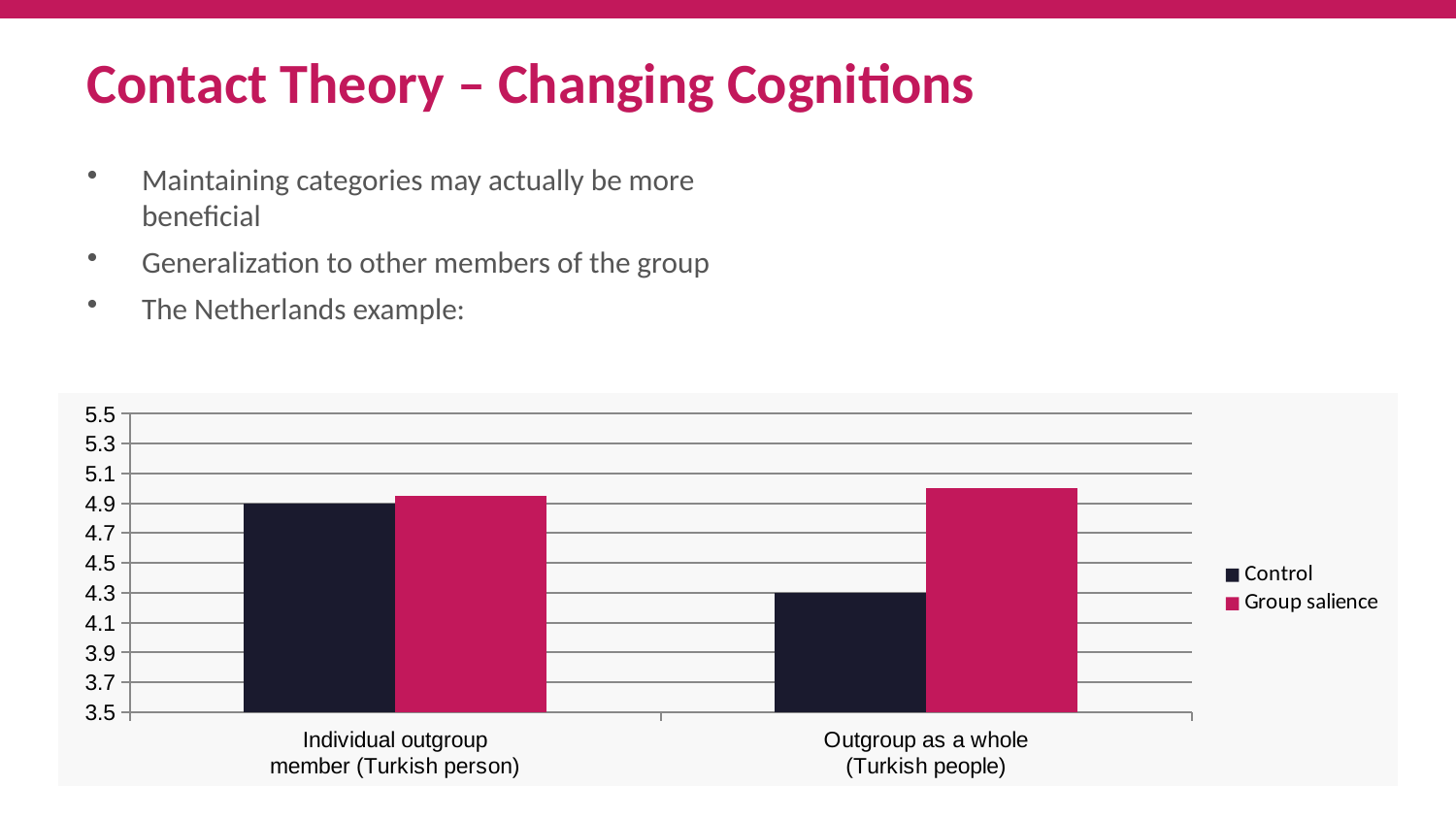
Is the Control value for Outgroup as a whole (Turkish people) greater or less than 4.5? less What is the Control value for Individual outgroup member (Turkish person)? 4.9 What are the two series named in the chart legend? Control and Group salience What kind of chart is shown on the slide? bar chart What is the Control value for Outgroup as a whole (Turkish people)? 4.3 For Outgroup as a whole (Turkish people), which series has the larger value, Control or Group salience? Group salience How many categories are shown on the x axis of the chart? 2 Which series is shown in dark navy bars in the chart? Control Is the Group salience value for Individual outgroup member (Turkish person) greater or less than 4.5? greater Which bar in the chart has the lowest value? Control for Outgroup as a whole (Turkish people) How many series does the chart legend list? 2 Is the Group salience value for Outgroup as a whole (Turkish people) greater or less than 4.7? greater